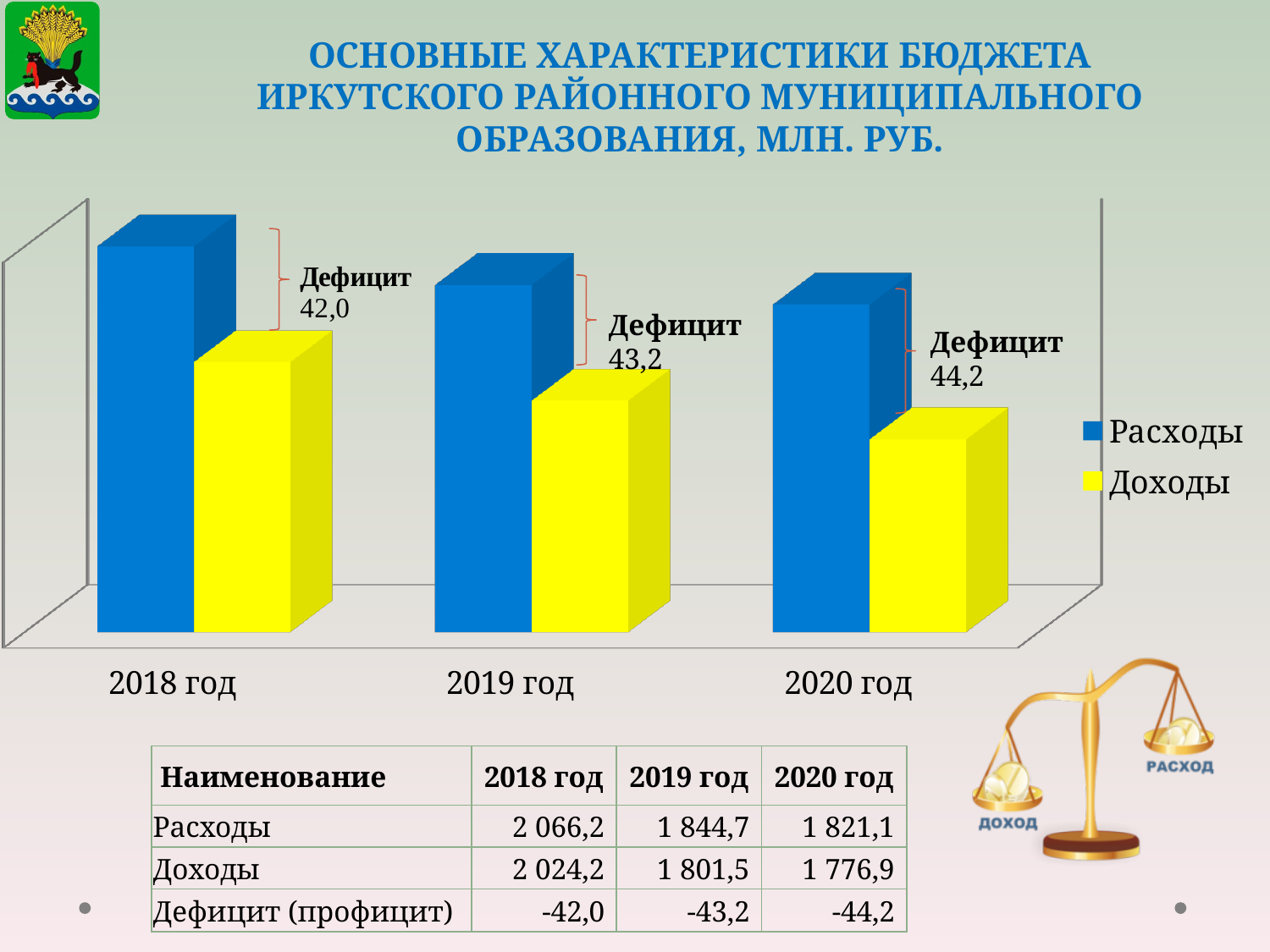
Which year has the highest Расходы bar? 2018 год How many series does the chart legend list? 2 Which colour represents Доходы in the chart legend? yellow What deficit (Дефицит) is annotated on the chart for 2020 год? 44,2 How many year categories are shown on the x axis of the chart? 3 Which year has the lowest Доходы bar? 2020 год What deficit (Дефицит) is annotated on the chart for 2018 год? 42,0 Do the Расходы values rise or fall from 2018 год to 2020 год? fall What is the value of Расходы for 2018 год? 2 066,2 What deficit (Дефицит) is annotated on the chart for 2019 год? 43,2 What is the value of Доходы for 2020 год? 1 776,9 What kind of chart is shown on the slide? bar chart